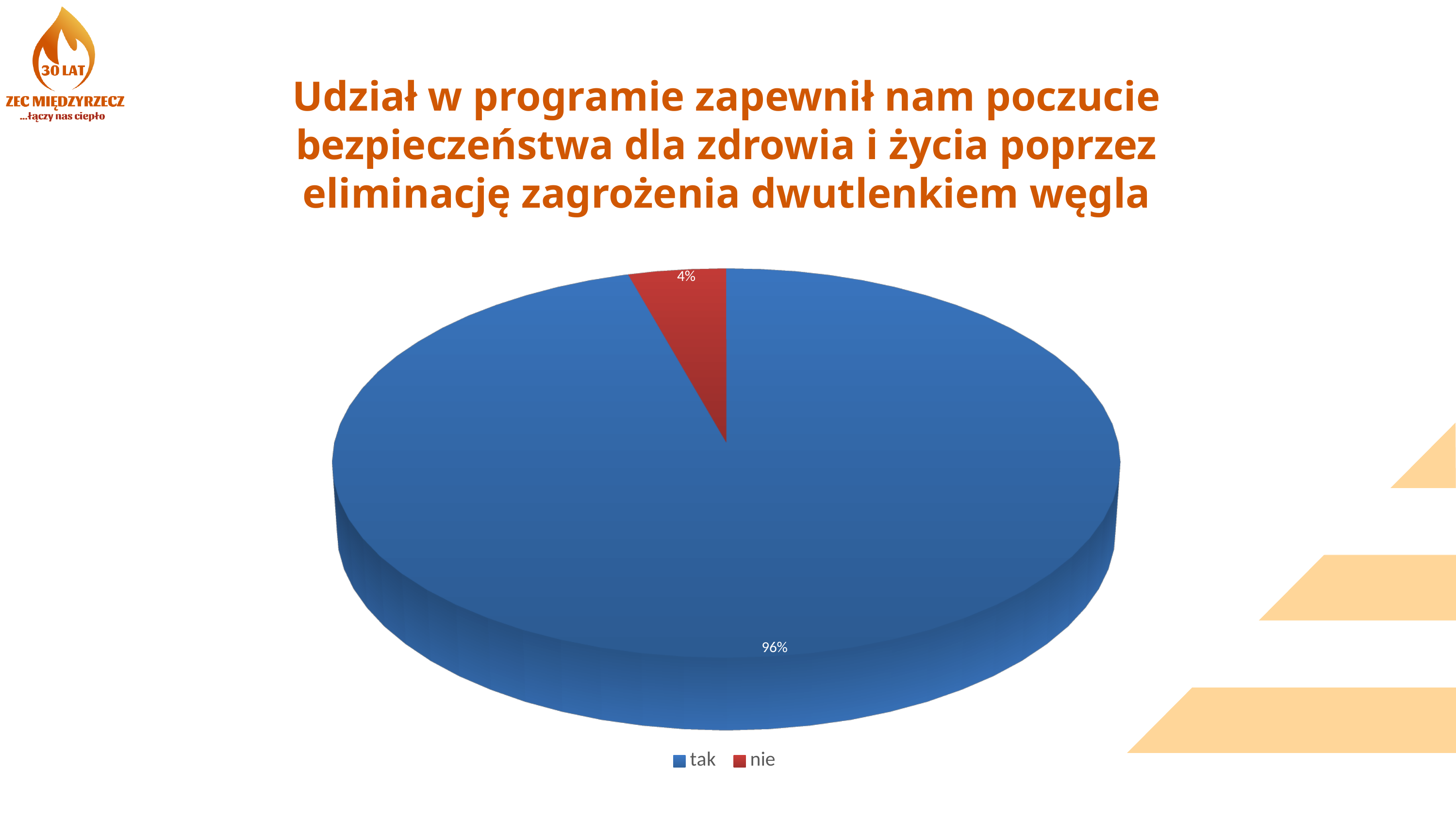
Which is larger, the "tak" slice or the "nie" slice? tak What is the difference in percentage points between the "tak" and "nie" slices? 92 Which category has the largest slice of the pie? tak What share of the pie does the "nie" slice represent? 4% What kind of chart is shown on the slide? pie chart How many categories does the pie chart show? 2 Which category has the smallest slice of the pie? nie What colour is the "nie" slice? red What are the two legend entries of the chart? tak, nie What share of the pie does the "tak" slice represent? 96%